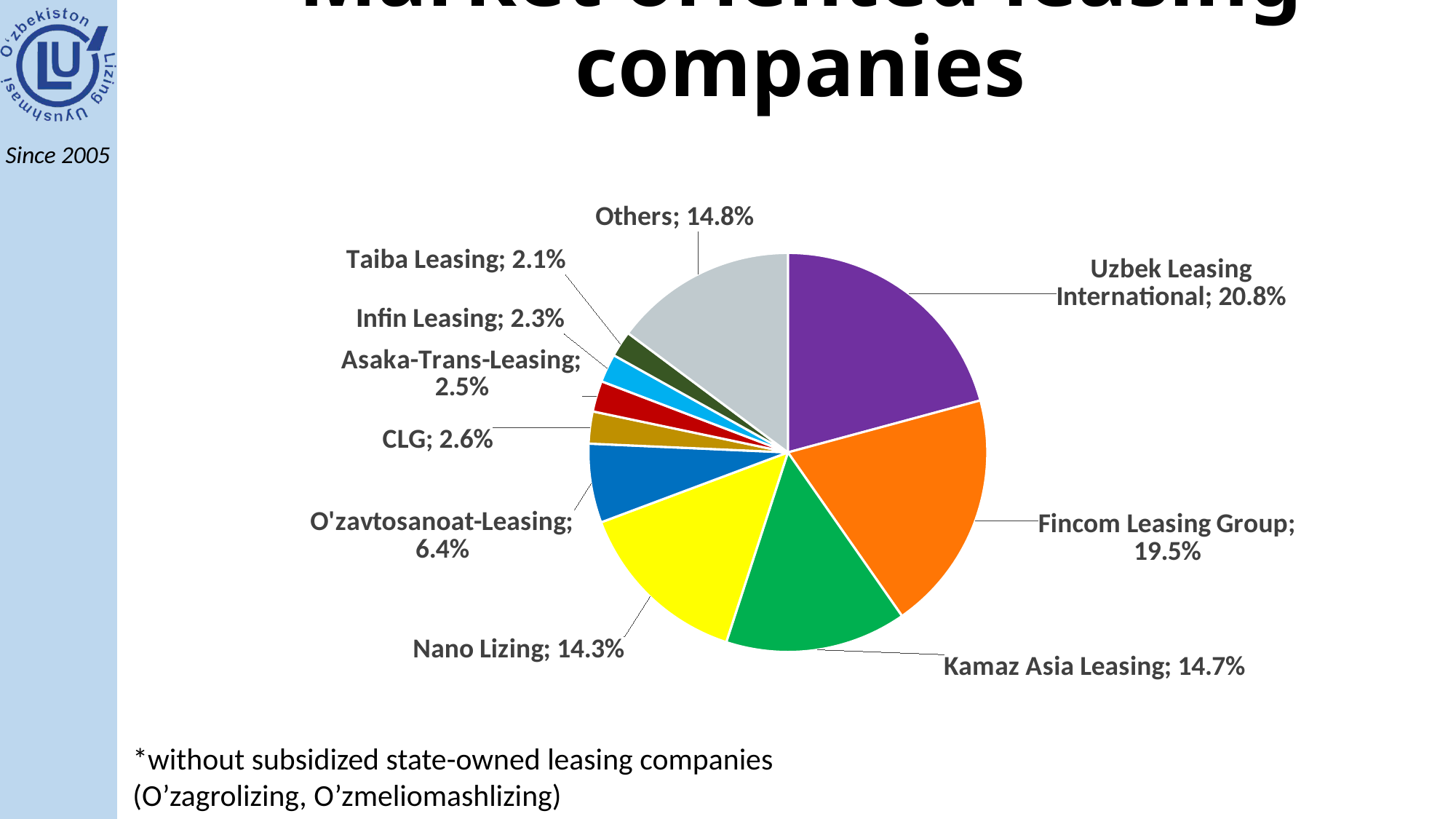
What is the value for O'zavtosanoat-Leasing? 6.4% What is the difference between the shares of Uzbek Leasing International and Fincom Leasing Group? 1.3% How many slices does the pie chart have? 10 Which is larger, the share of Kamaz Asia Leasing or the share of Nano Lizing? Kamaz Asia Leasing Which named company has the smallest slice of the pie? Taiba Leasing What is the value shown for Fincom Leasing Group? 19.5% What percentage is shown for Nano Lizing? 14.3% What share of the pie does Uzbek Leasing International hold? 20.8% What colour is the slice for Fincom Leasing Group? Orange Which company has the largest slice of the pie? Uzbek Leasing International What is the difference between the shares of Others and Nano Lizing? 0.5% What type of chart is shown on the slide? Pie chart